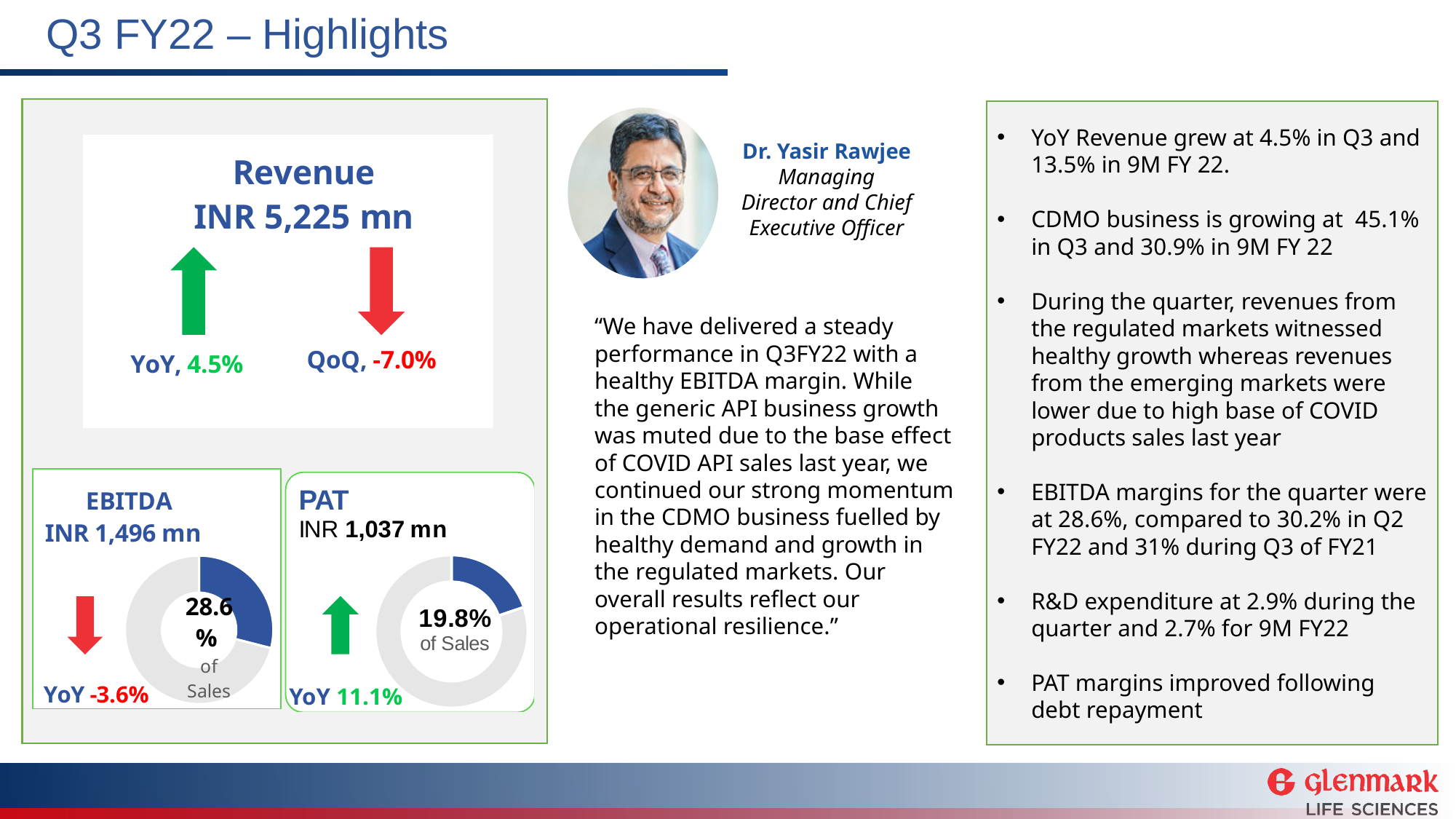
In the EBITDA donut chart, what percentage of sales does the filled segment represent? 28.6% What text is printed in the centre of the PAT donut chart? 19.8% of Sales Is the PAT share of sales shown in the PAT donut chart greater or less than 20%? less In the PAT donut chart, what percentage of sales does the filled segment represent? 19.8% How many donut charts are shown on the slide? 2 Is the EBITDA share of sales shown in the EBITDA donut chart greater or less than 25%? greater What colour is the filled segment in the EBITDA and PAT donut charts? Blue In the PAT donut chart, what share of the ring is left unfilled (grey), given the filled segment is 19.8%? 80.2% What kind of chart is used to show the EBITDA margin as a share of sales? Donut chart What is the difference in percentage points between the EBITDA share of sales (28.6%) and the PAT share of sales (19.8%) shown in the donut charts? 8.8 percentage points Which donut chart shows the larger share of sales, EBITDA or PAT? EBITDA